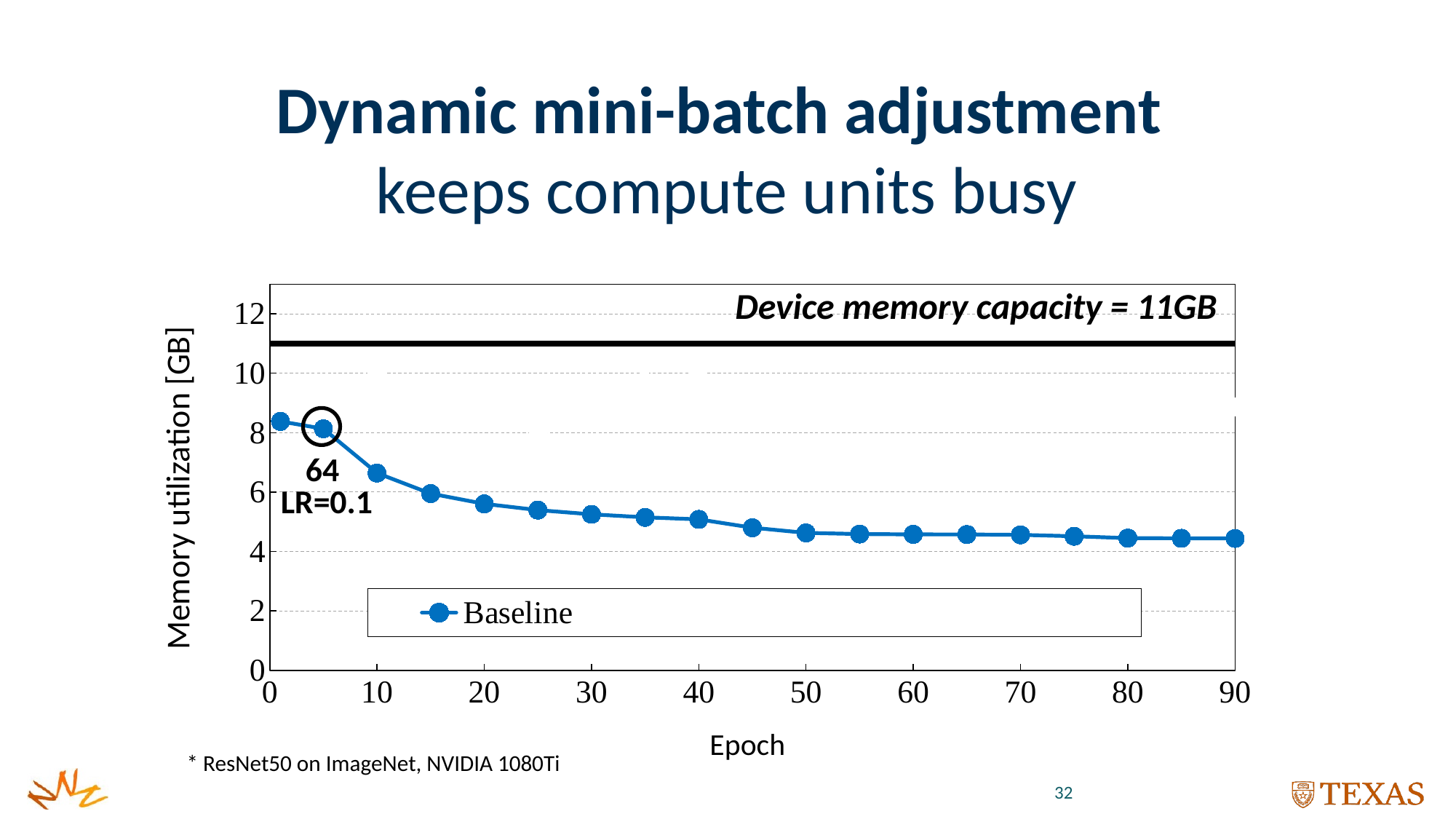
What kind of chart is shown on the slide? line chart What is the label of the y axis? Memory utilization [GB] What is the name of the series in the legend? Baseline What is the device memory capacity indicated by the horizontal line? 11GB Is the memory utilization at epoch 10 greater or less than 6? greater Is the memory utilization at epoch 90 greater or less than 6? less How many series does the legend list? 1 Does memory utilization rise or fall as the epoch increases? fall How many data points are plotted for the Baseline series? 19 Is the memory utilization at epoch 50 greater or less than 4? greater Which is larger, the memory utilization at epoch 10 or at epoch 40? epoch 10